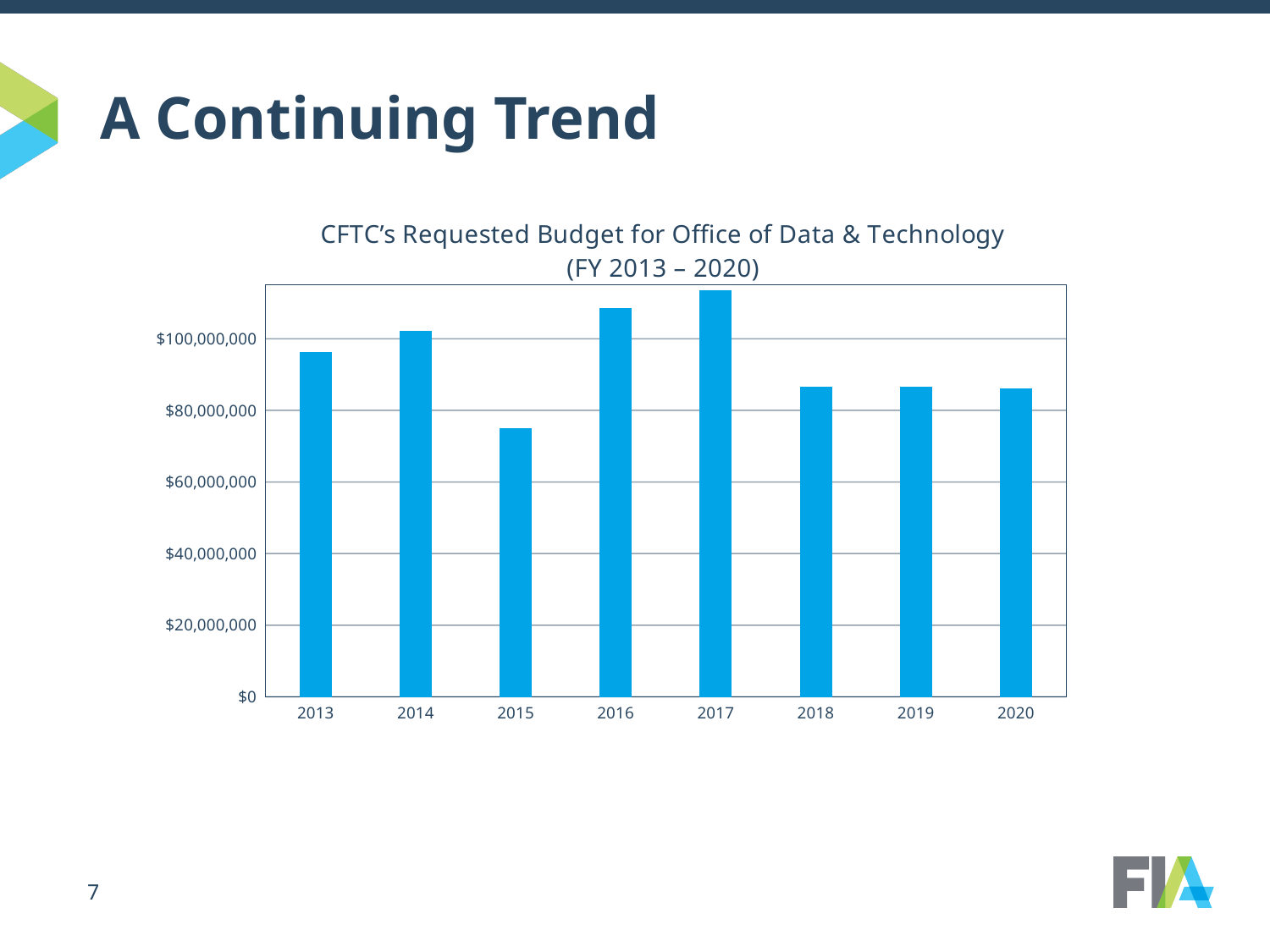
Is the value for 2013 greater or less than $100,000,000? less Which year has the highest requested budget? 2017 Between 2015 and 2017, do the values rise or fall? rise What is the title of the chart? CFTC's Requested Budget for Office of Data & Technology (FY 2013 – 2020) Is the value for 2020 greater or less than $80,000,000? greater Which year has the lowest requested budget? 2015 Which year has the larger requested budget, 2016 or 2013? 2016 How many fiscal years are plotted on the chart? 8 Is the value for 2016 greater or less than $100,000,000? greater What kind of chart is shown on the slide? Bar chart Which year has the larger requested budget, 2015 or 2018? 2018